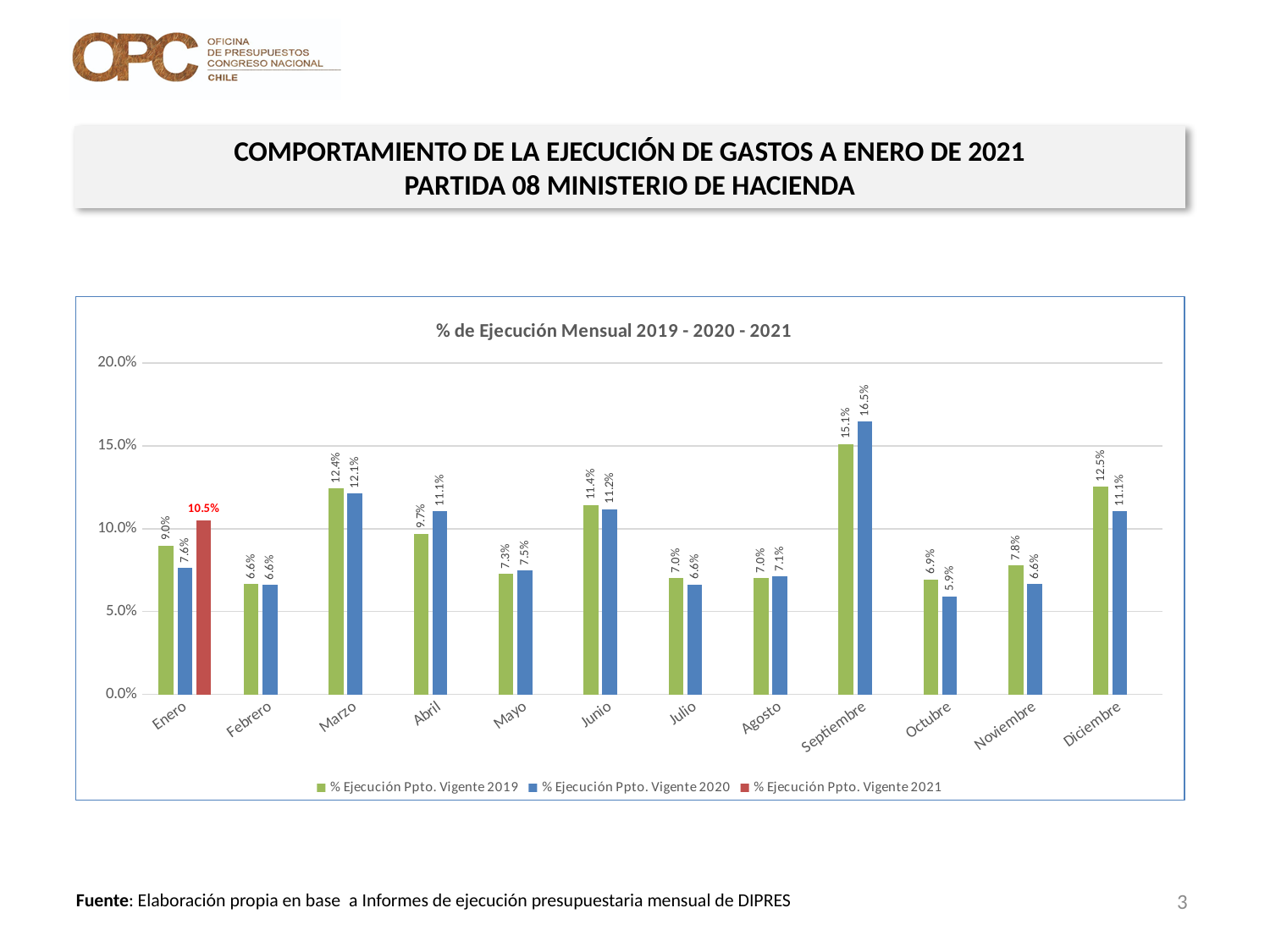
What is the value for Abril in the % Ejecución Ppto. Vigente 2019 series? 9.7% Which month has the highest value in the % Ejecución Ppto. Vigente 2019 series? Septiembre How many months are shown on the x axis? 12 What is the title of the chart? % de Ejecución Mensual 2019 - 2020 - 2021 For Abril, which series has the larger value: % Ejecución Ppto. Vigente 2019 or % Ejecución Ppto. Vigente 2020? % Ejecución Ppto. Vigente 2020 How many series does the legend list? 3 What is the difference between the 2020 and 2019 values for Septiembre? 1.4% What is the difference between the 2019 and 2020 values for Diciembre? 1.4% What kind of chart is shown on the slide? Bar chart What is the value for Septiembre in the % Ejecución Ppto. Vigente 2020 series? 16.5% What is the value for Enero in the % Ejecución Ppto. Vigente 2021 series? 10.5% Which month has the lowest value in the % Ejecución Ppto. Vigente 2020 series? Octubre